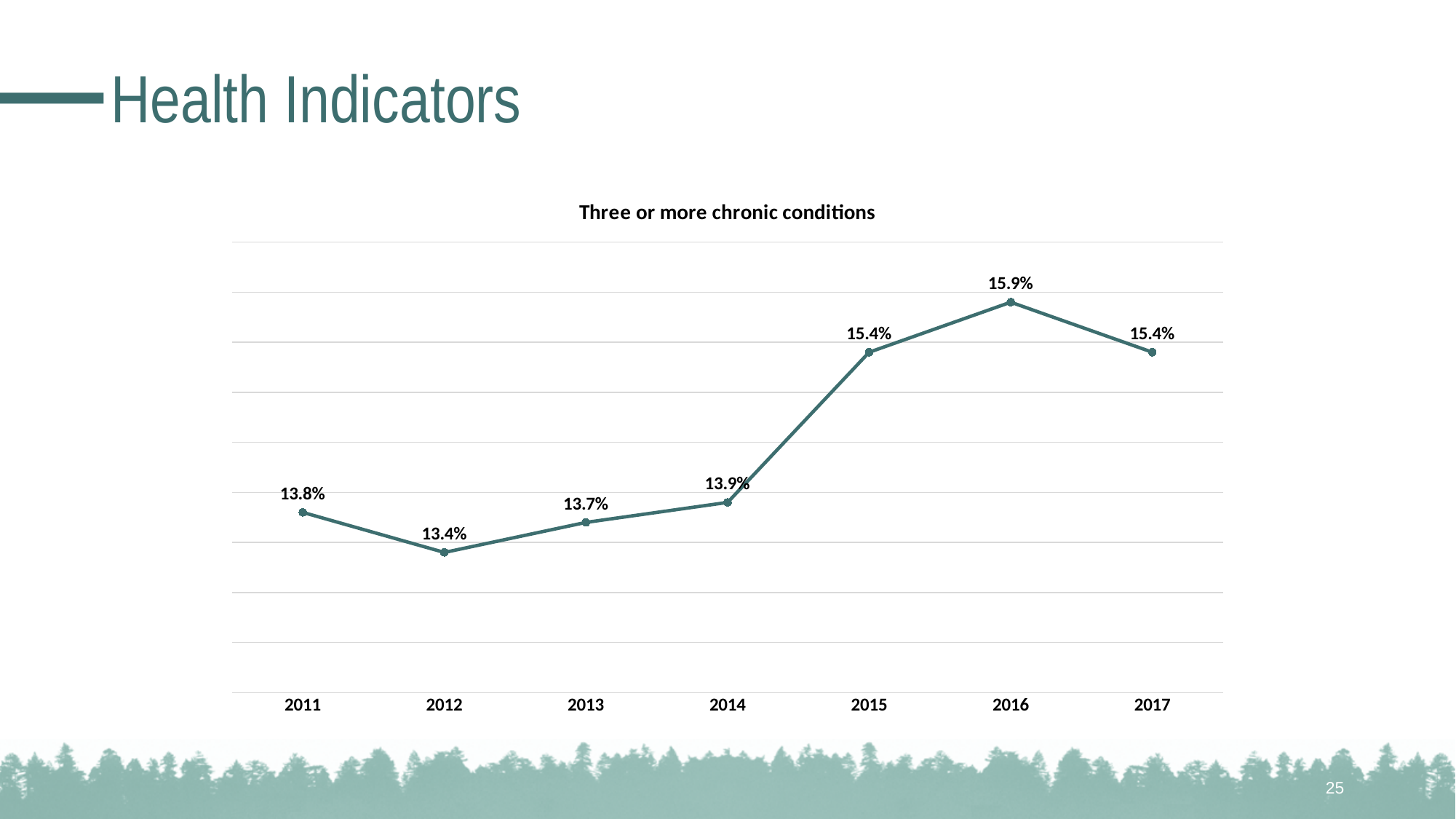
What kind of chart is shown? line chart Which year has the highest value? 2016 What is the difference between the values for 2015 and 2014? 1.5% What is the difference between the values for 2016 and 2012? 2.5% What is the value for 2014? 13.9% Which year has the lowest value? 2012 What is the value for 2011? 13.8% How many years are plotted on the chart? 7 Do the values generally rise or fall from 2012 to 2016? rise What is the value for 2016? 15.9% What is the title of the chart? Three or more chronic conditions Which is larger, the value for 2013 or the value for 2015? 2015